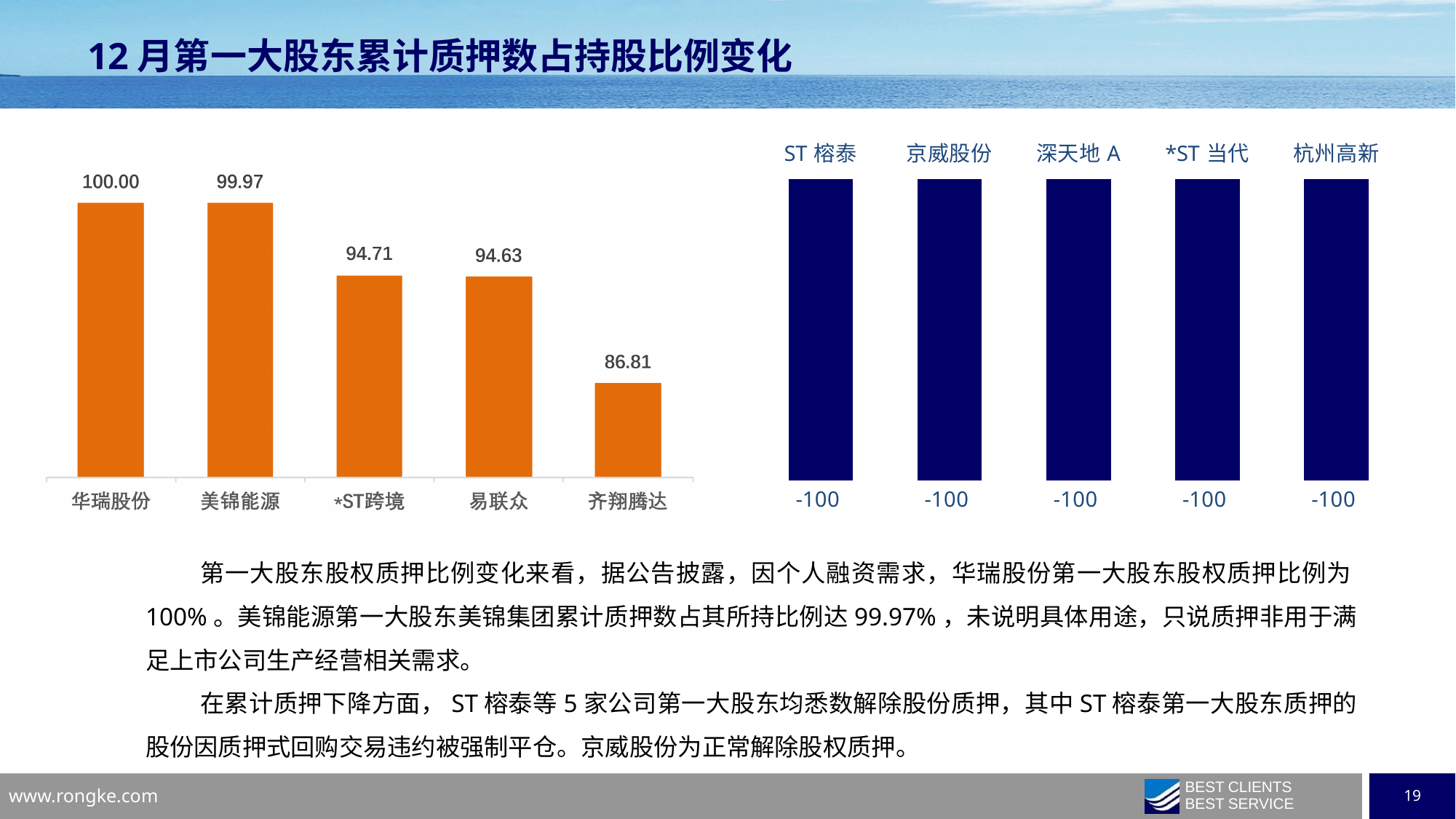
In the left chart, what is the value for 齐翔腾达? 86.81 In the left chart, which is larger, the value for 美锦能源 or the value for 易联众? 美锦能源 In the right chart, what is the value for 京威股份? -100 In the left chart, what is the value for 华瑞股份? 100.00 What type of chart is the right chart? bar chart In the left chart, what is the difference between the values for 美锦能源 and 齐翔腾达? 13.16 In the left chart, do the values rise or fall from left to right? fall In the left chart, which category has the highest value? 华瑞股份 How many categories are shown in the right chart? 5 How many categories are shown in the left chart? 5 In the left chart, what is the value for *ST跨境? 94.71 In the left chart, which category has the lowest value? 齐翔腾达